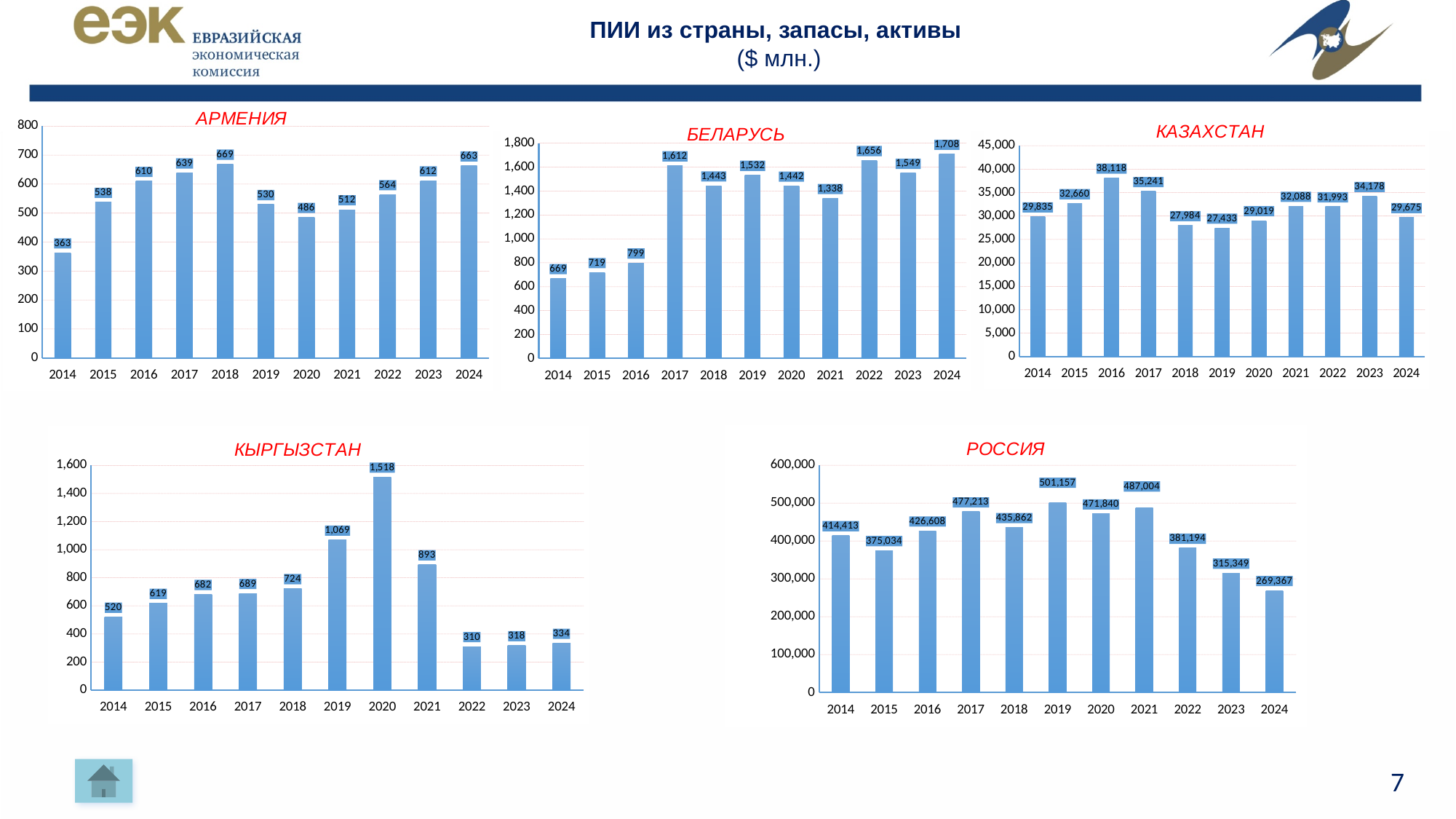
In the АРМЕНИЯ chart, what is the value for 2018? 669 In the КЫРГЫЗСТАН chart, what is the difference between the values for 2020 and 2021? 625 In the РОССИЯ chart, which is larger, the value for 2015 or the value for 2022? 2022 What kind of chart is the КЫРГЫЗСТАН chart? bar chart In the БЕЛАРУСЬ chart, what is the difference between the values for 2024 and 2014? 1,039 In the РОССИЯ chart, what is the value for 2019? 501,157 In the БЕЛАРУСЬ chart, which year has the highest value? 2024 In the КАЗАХСТАН chart, which year has the lowest value? 2019 In the АРМЕНИЯ chart, which year has the lowest value? 2014 In the КАЗАХСТАН chart, what is the value for 2016? 38,118 In the КЫРГЫЗСТАН chart, which year has the highest value? 2020 In the РОССИЯ chart, how many years are plotted? 11